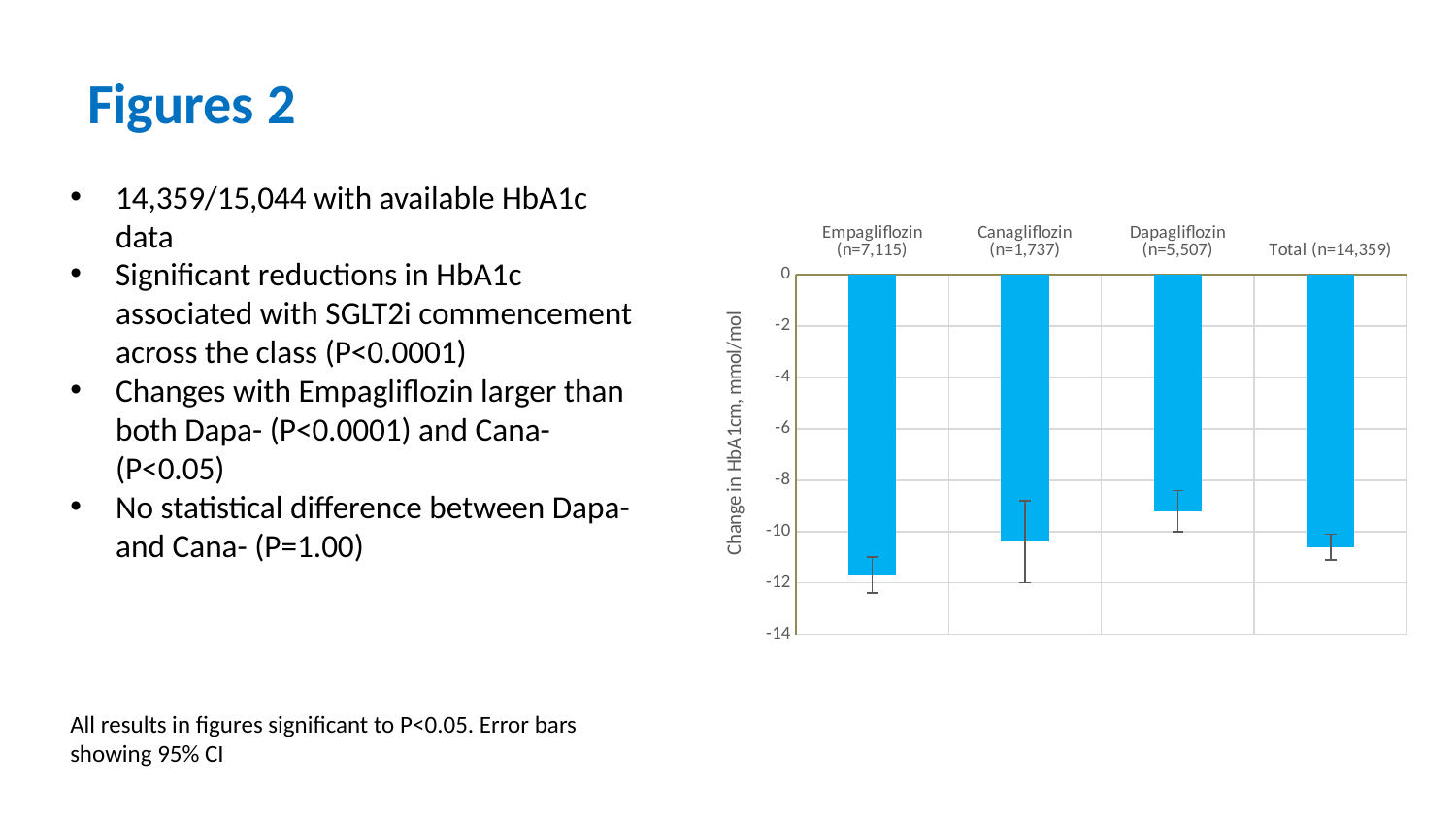
How many bars are plotted in the chart? 4 Which bar shows a larger reduction in HbA1c, Empagliflozin or Dapagliflozin? Empagliflozin Is the value for Canagliflozin greater or less than -8? less Is the value for Dapagliflozin greater or less than -10? greater What is the sample size shown for Canagliflozin in the chart's category label? n=1,737 Is the value for Empagliflozin greater or less than -10? less Which category shows the largest reduction in HbA1c (the bar extending furthest below zero)? Empagliflozin (n=7,115) What kind of chart is shown on the slide? bar chart What is the label on the vertical axis of the chart? Change in HbA1cm, mmol/mol Which category shows the smallest reduction in HbA1c (the shortest bar)? Dapagliflozin (n=5,507)